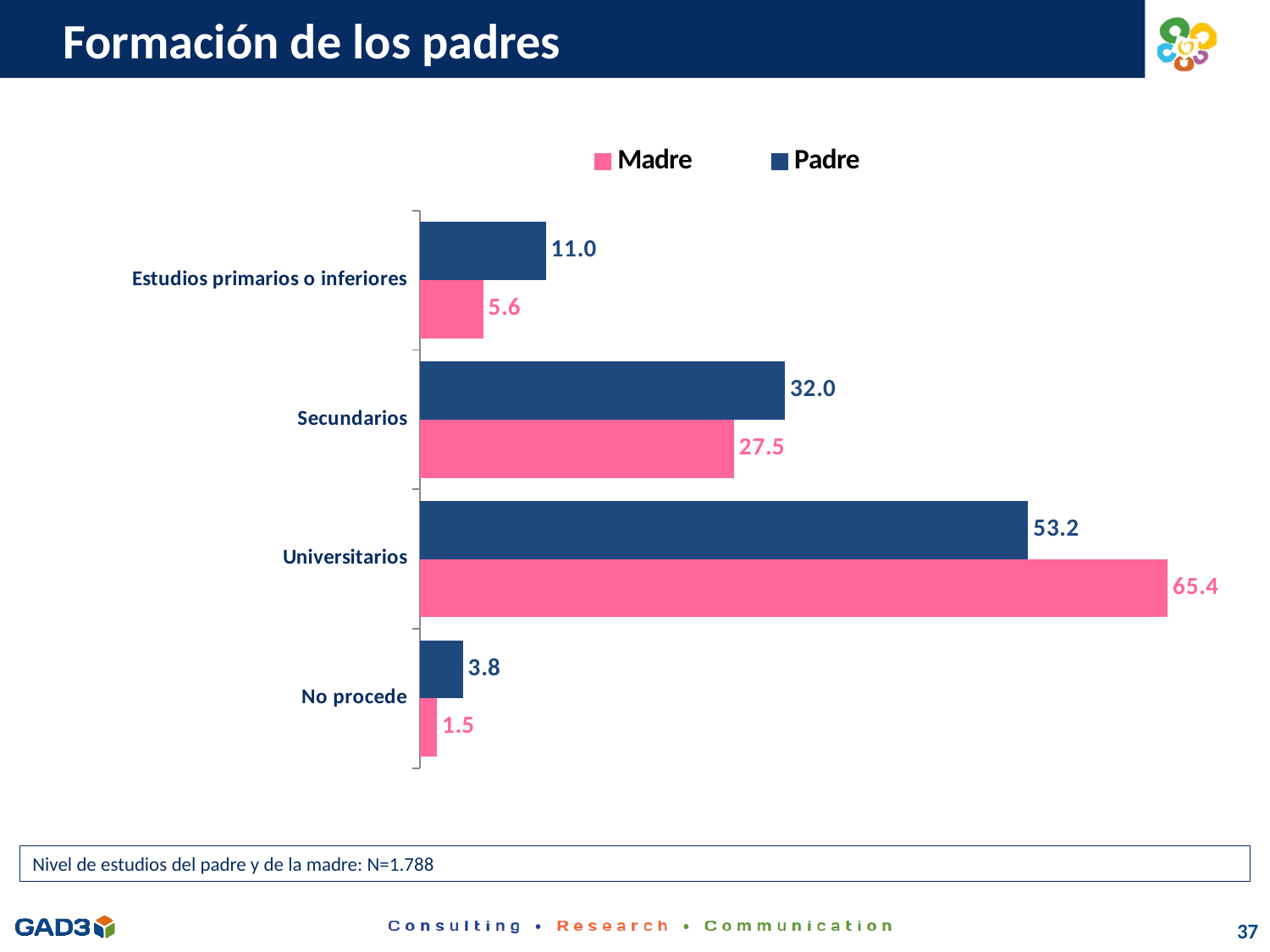
What is the value for Padre in the Universitarios category? 53.2 What is the difference between the Padre and Madre values in the Estudios primarios o inferiores category? 5.4 What is the difference between the Madre and Padre values in the Universitarios category? 12.2 Which is larger in the Secundarios category, the Madre value or the Padre value? Padre Which category has the highest value for Madre? Universitarios What is the value for Madre in the Secundarios category? 27.5 Which category has the lowest value for Padre? No procede What is the value for Padre in the No procede category? 3.8 How many series does the legend list? 2 How many categories are shown on the chart? 4 What is the value for Madre in the Estudios primarios o inferiores category? 5.6 What kind of chart is shown on the slide? Bar chart